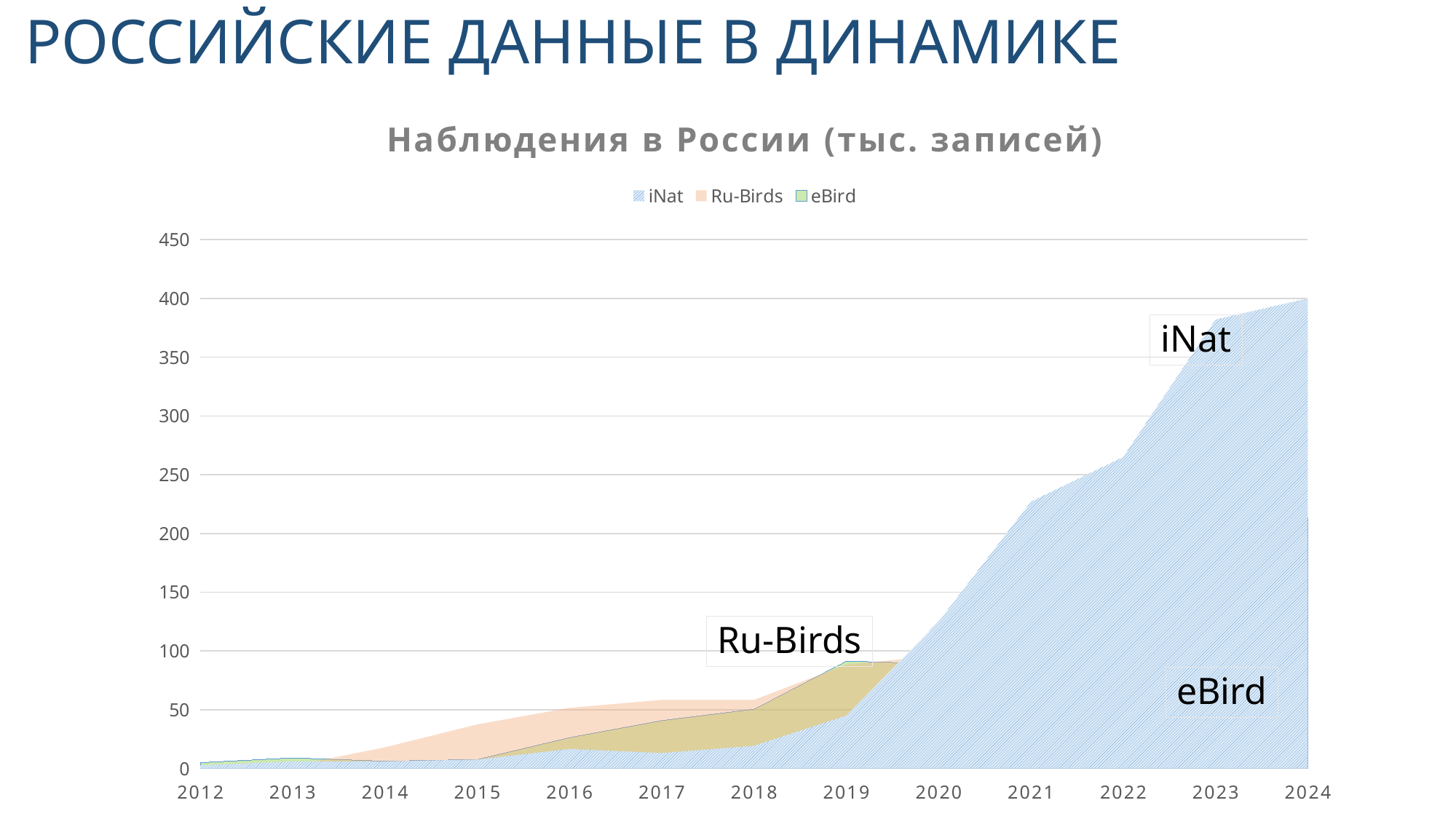
Does the iNat series rise or fall from 2012 to 2024? rise Is the iNat value for 2021 greater or less than 200? greater Which series are listed in the legend? iNat, Ru-Birds, eBird What is the title of the chart? Наблюдения в России (тыс. записей) What kind of chart is shown on the slide? area chart How many years are shown on the x axis? 13 How many series does the legend list? 3 Which is larger, the iNat value for 2024 or the iNat value for 2020? 2024 Is the Ru-Birds value for 2017 greater or less than 100? less Is the iNat value for 2018 greater or less than 50? less In which year does the iNat series reach its highest value? 2024